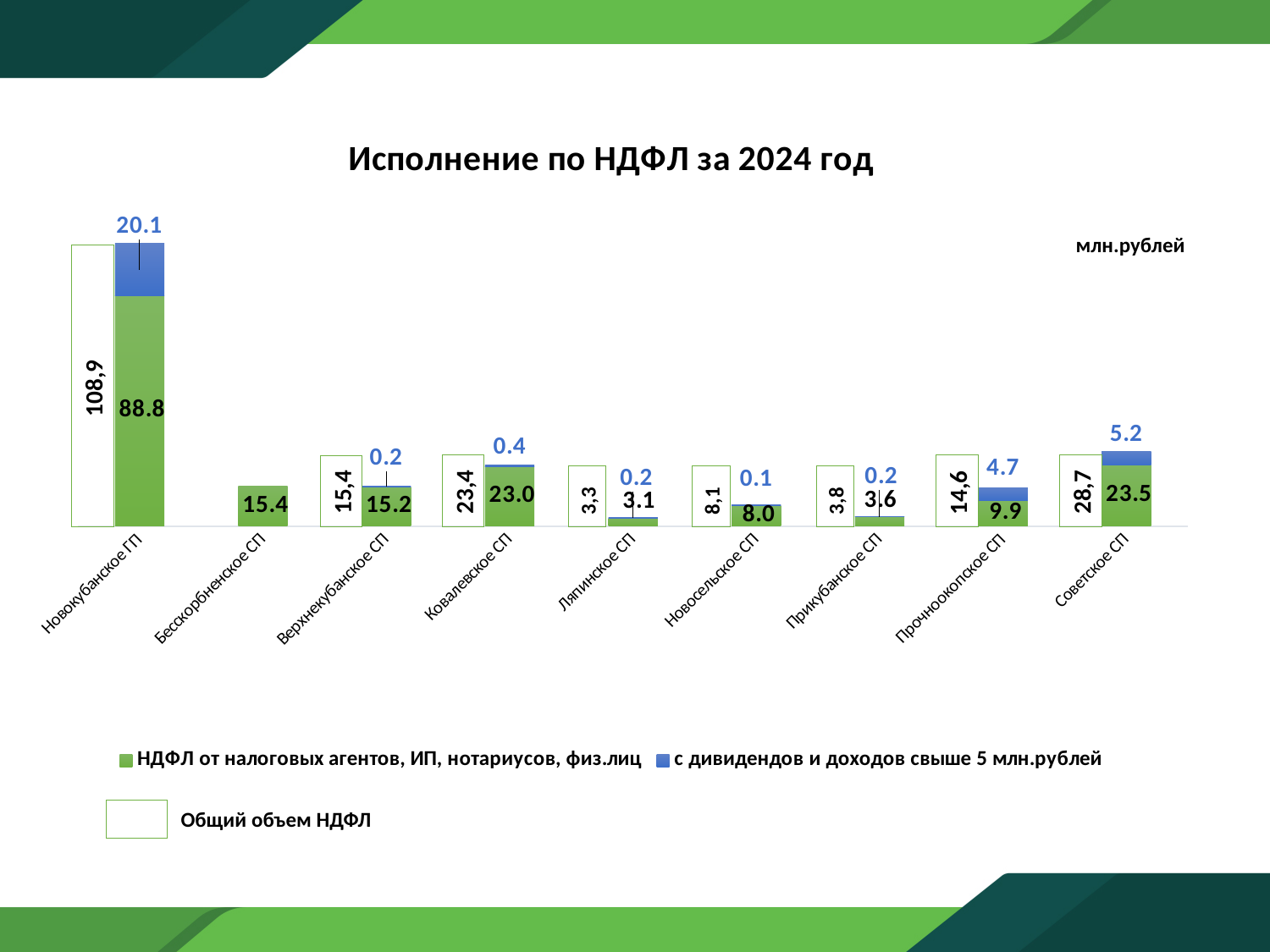
What is the value of the green series (НДФЛ от налоговых агентов, ИП, нотариусов, физ.лиц) for Советское СП? 23.5 What is the title of the chart? Исполнение по НДФЛ за 2024 год Which has a larger green series value: Прочноокопское СП or Новосельское СП? Прочноокопское СП What is the difference between the blue series values for Новокубанское ГП and Советское СП? 14.9 How many categories are shown on the x axis of the chart? 9 What kind of chart is shown on the slide? Bar chart What is the value of the blue series (с дивидендов и доходов свыше 5 млн.рублей) for Прочноокопское СП? 4.7 What is the difference between the green series values for Новокубанское ГП and Советское СП? 65.3 What is the Общий объем НДФЛ value shown for Ковалевское СП? 23,4 Which category has the lowest labelled value for the blue series (с дивидендов и доходов свыше 5 млн.рублей)? Новосельское СП Which category has the highest value for the green series (НДФЛ от налоговых агентов, ИП, нотариусов, физ.лиц)? Новокубанское ГП In what units are the values on the chart expressed? млн.рублей